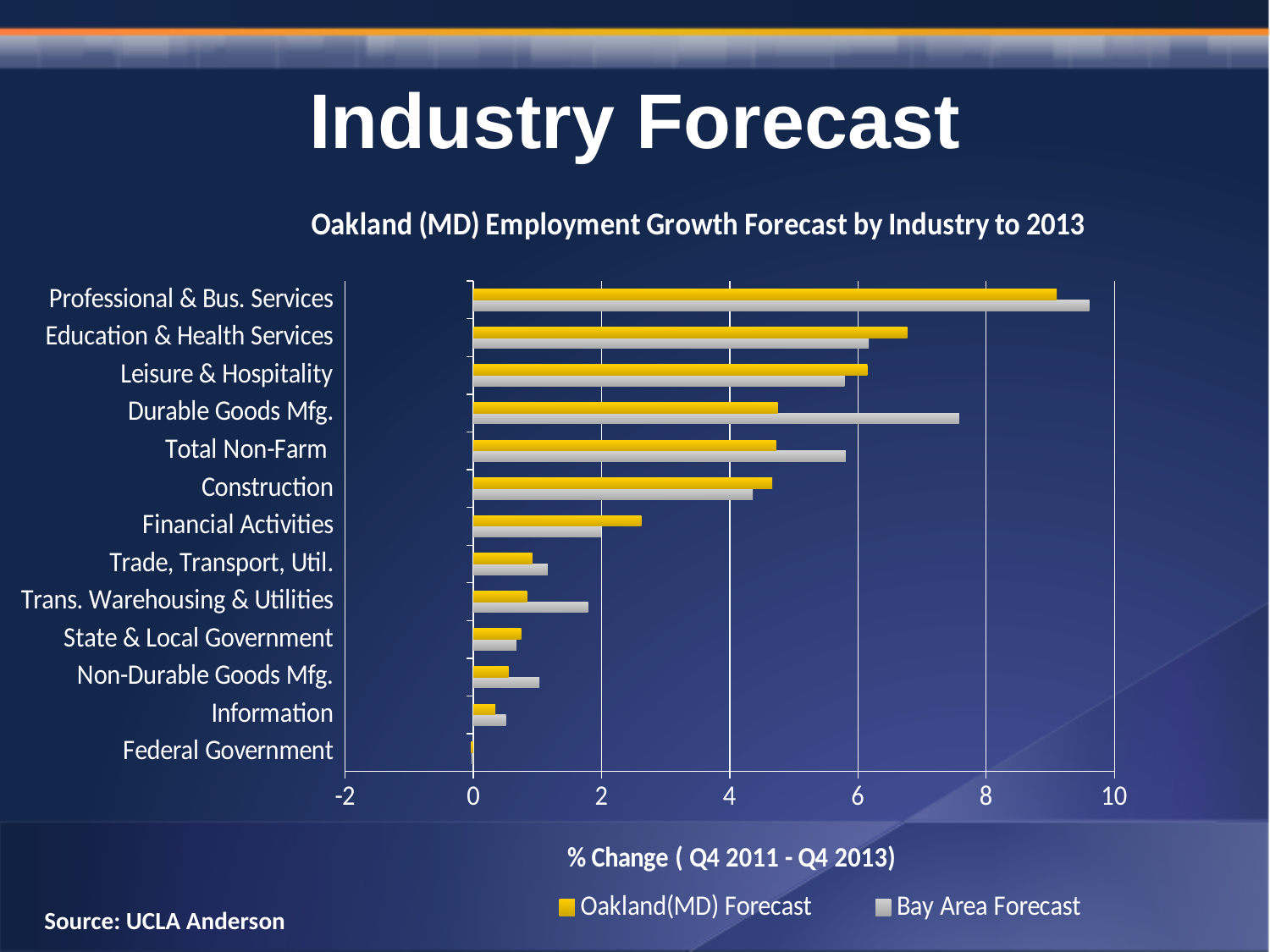
How many series does the legend list? 2 What is the label of the horizontal axis? % Change ( Q4 2011 - Q4 2013) For Education & Health Services, which is larger: the Oakland(MD) Forecast or the Bay Area Forecast? Oakland(MD) Forecast For Durable Goods Mfg., which is larger: the Oakland(MD) Forecast or the Bay Area Forecast? Bay Area Forecast How many industry categories are plotted on the chart? 13 Which industry has the highest Oakland(MD) Forecast value? Professional & Bus. Services What kind of chart is shown on the slide? Bar chart Is the Oakland(MD) Forecast value for Trade, Transport, Util. greater or less than 2? less What is the title of the chart? Oakland (MD) Employment Growth Forecast by Industry to 2013 Is the Bay Area Forecast value for Durable Goods Mfg. greater or less than 6? greater Which industry has the lowest Oakland(MD) Forecast value? Federal Government Is the Oakland(MD) Forecast value for Professional & Bus. Services greater or less than 8? greater